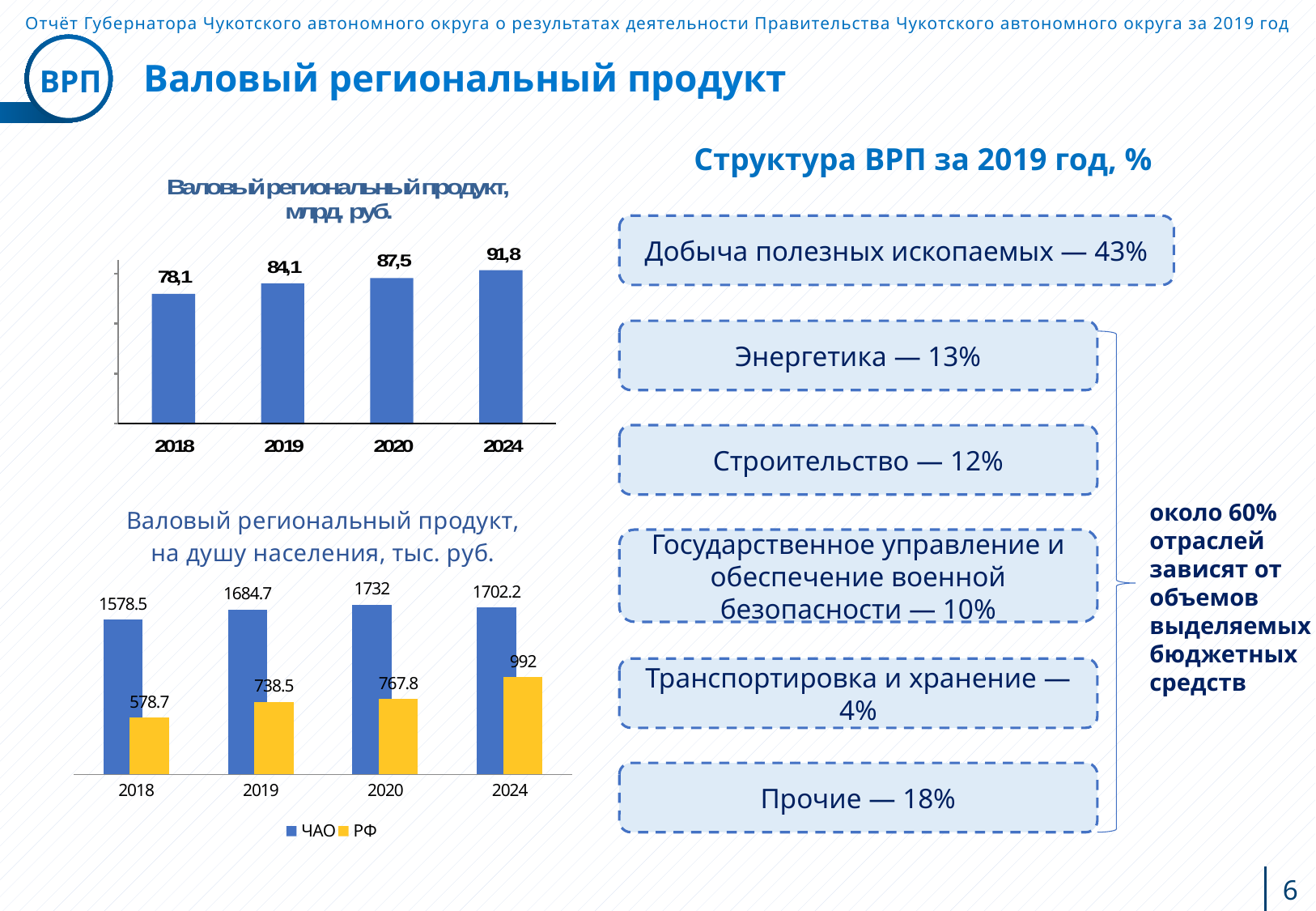
In the top chart (Валовый региональный продукт, млрд. руб.), what is the difference between the 2024 and 2018 values? 13,7 In the top chart (Валовый региональный продукт, млрд. руб.), do the values rise or fall from 2018 to 2024? rise In the bottom chart (Валовый региональный продукт, на душу населения, тыс. руб.), which year has the highest ЧАО value? 2020 In the top chart (Валовый региональный продукт, млрд. руб.), which year has the highest value? 2024 In the bottom chart (Валовый региональный продукт, на душу населения, тыс. руб.), what is the value for РФ in 2020? 767.8 What type of chart is the bottom chart (Валовый региональный продукт, на душу населения, тыс. руб.)? bar chart In the top chart (Валовый региональный продукт, млрд. руб.), what is the value for 2019? 84,1 In the bottom chart (Валовый региональный продукт, на душу населения, тыс. руб.), what is the value for ЧАО in 2024? 1702.2 How many series does the legend of the bottom chart (Валовый региональный продукт, на душу населения, тыс. руб.) list? 2 How many years are shown in the top chart (Валовый региональный продукт, млрд. руб.)? 4 In the top chart (Валовый региональный продукт, млрд. руб.), which year has the lowest value? 2018 In the bottom chart (Валовый региональный продукт, на душу населения, тыс. руб.), what is the difference between ЧАО and РФ in 2018? 999.8